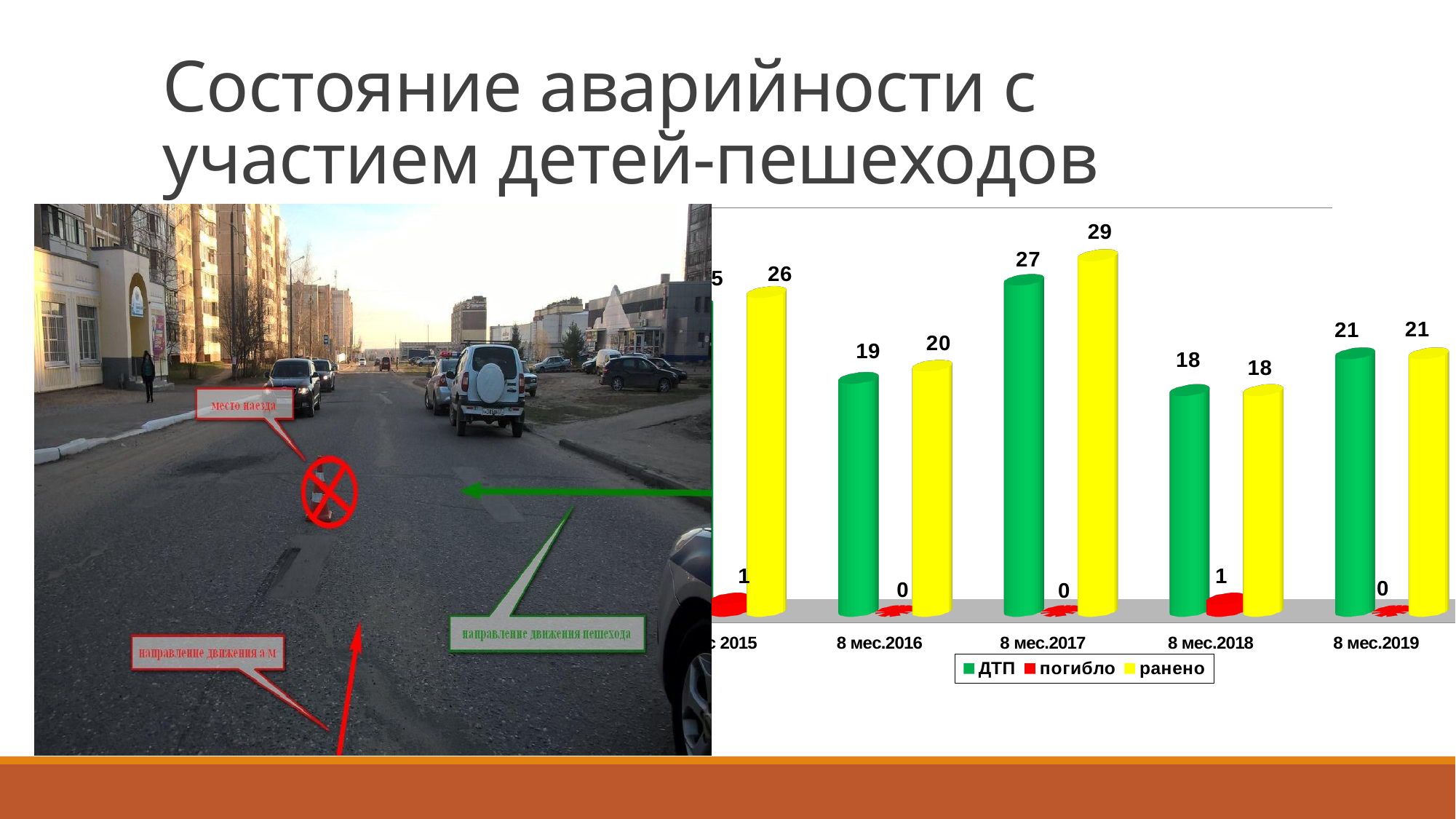
What colour are the bars for the ранено series? yellow What is the difference between ДТП for 8 мес.2017 and ДТП for 8 мес.2016? 8 What is the value of ранено for 8 мес.2016? 20 What is the value of ДТП for 8 мес.2019? 21 What is the value of погибло for 8 мес.2017? 0 Which is larger for 8 мес.2016: ДТП or ранено? ранено What kind of chart is shown on the slide? bar chart What is the value of ДТП for 8 мес.2017? 27 How many series does the legend list? 3 Which period has the lowest value for ранено? 8 мес.2018 Which period has the highest value for ранено? 8 мес.2017 What is the value of погибло for 8 мес.2018? 1